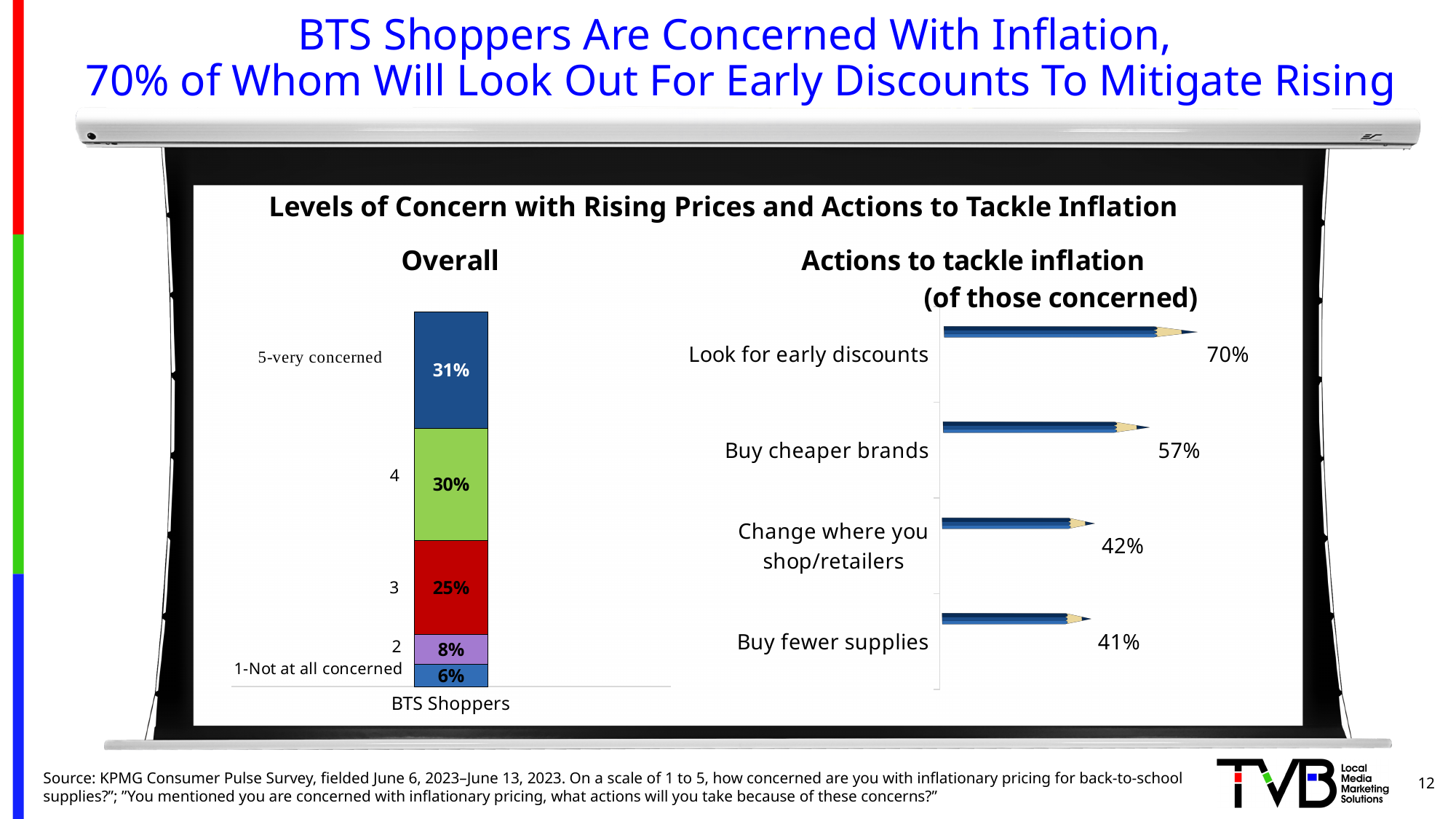
What kind of chart is the 'Actions to tackle inflation' chart? Bar chart In the 'Overall' chart, what percentage of BTS Shoppers gave a concern level of 3? 25% In the 'Actions to tackle inflation' chart, what percentage will 'Buy cheaper brands'? 57% In the 'Actions to tackle inflation' chart, how many actions are listed? 4 In the 'Overall' chart, what is the total of all segments in the BTS Shoppers stacked bar? 100% In the 'Overall' chart, which concern level has the smallest share of BTS Shoppers? 1-Not at all concerned In the 'Actions to tackle inflation' chart, what is the difference between 'Look for early discounts' and 'Change where you shop/retailers'? 28% In the 'Overall' chart, which concern level has the largest share of BTS Shoppers? 5-very concerned In the 'Actions to tackle inflation' chart, which action has the lowest percentage? Buy fewer supplies In the 'Overall' chart, what percentage of BTS Shoppers are '1-Not at all concerned'? 6% In the 'Overall' chart, what percentage of BTS Shoppers are '5-very concerned'? 31% In the 'Overall' chart, what is the difference between the share at level 4 and the share at level 2? 22%